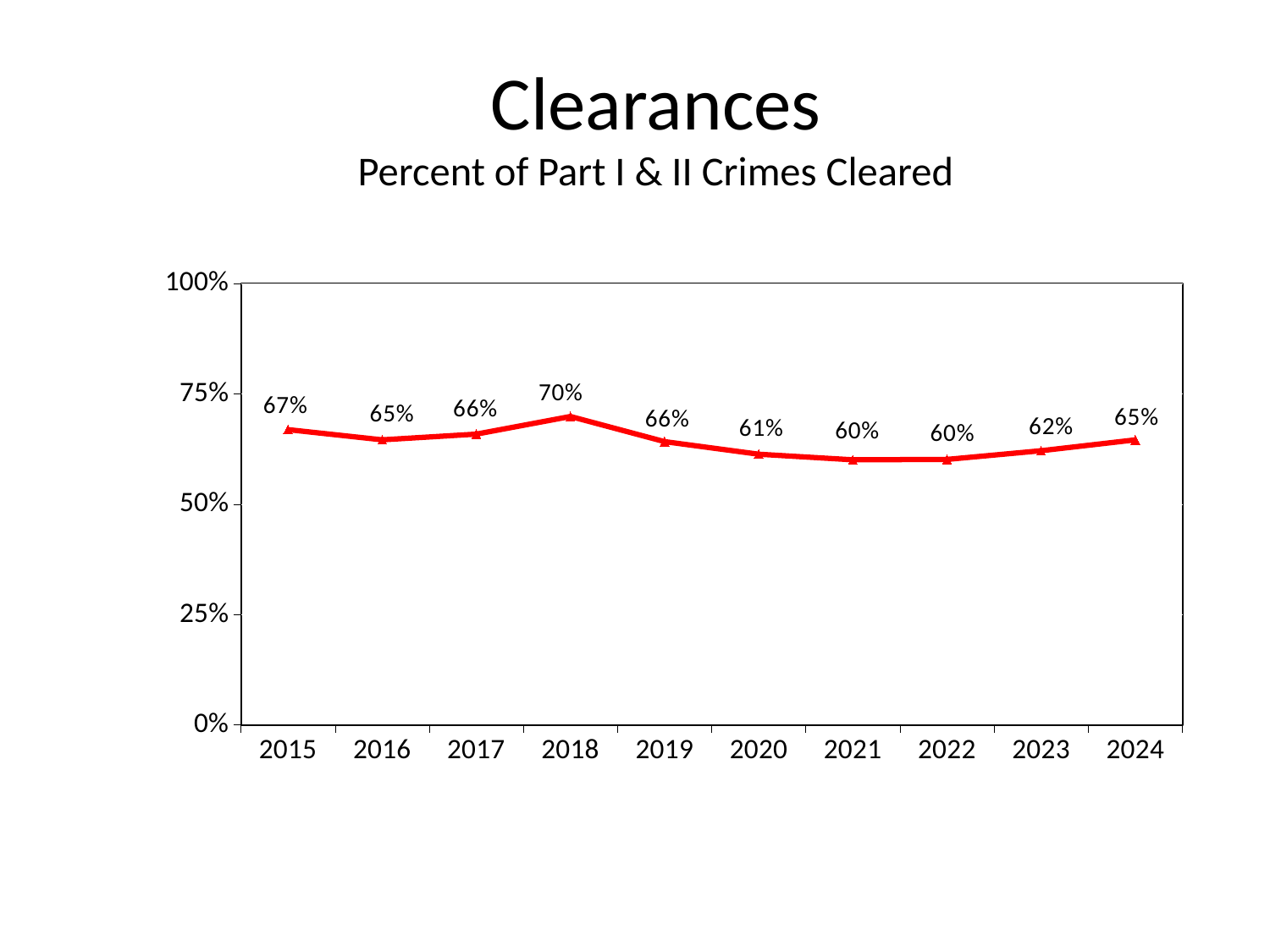
What is the lowest clearance percentage shown on the chart? 60% What is the clearance percentage shown for 2024? 65% What is the difference between the 2018 value and the 2022 value? 10% Is the value for 2021 greater or less than 75%? less What percent of Part I & II crimes were cleared in 2018? 70% Which year has a higher clearance percentage, 2015 or 2020? 2015 Which year has the highest clearance percentage? 2018 What value is plotted for 2015? 67% What kind of chart is shown on the slide? line chart Do the values rise or fall from 2018 to 2021? fall What is the subtitle of the chart? Percent of Part I & II Crimes Cleared How many years are plotted on the x axis? 10